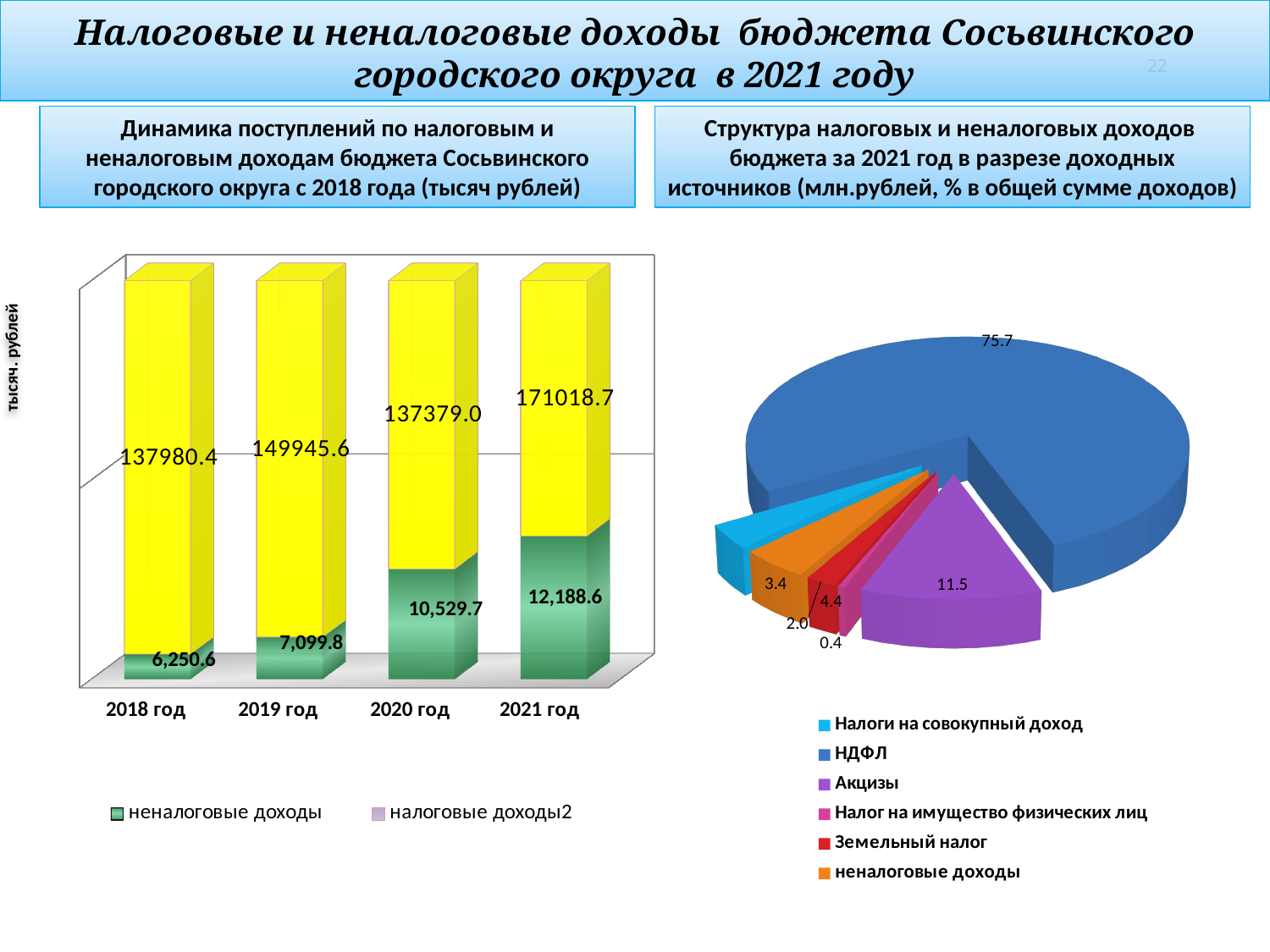
How many years are shown on the x axis of the left bar chart? 4 In the pie chart on the right, which category has the largest slice? НДФЛ In the left bar chart, which year has the lowest value of неналоговые доходы? 2018 год In the left bar chart, what is the value of налоговые доходы for 2019 год? 149945.6 In the left bar chart, what is the difference between неналоговые доходы in 2021 год and 2020 год? 1,658.9 What kind of chart is shown on the right side of the slide? pie chart In the left bar chart, do the values of неналоговые доходы rise or fall from 2018 год to 2021 год? rise In the left bar chart, which year has the highest value of налоговые доходы? 2021 год In the left bar chart, which year has the larger value of налоговые доходы: 2018 год or 2020 год? 2018 год In the pie chart on the right, what share is shown for НДФЛ? 75.7 In the left bar chart, what is the value of неналоговые доходы for 2021 год? 12,188.6 How many series does the legend of the left chart list? 2